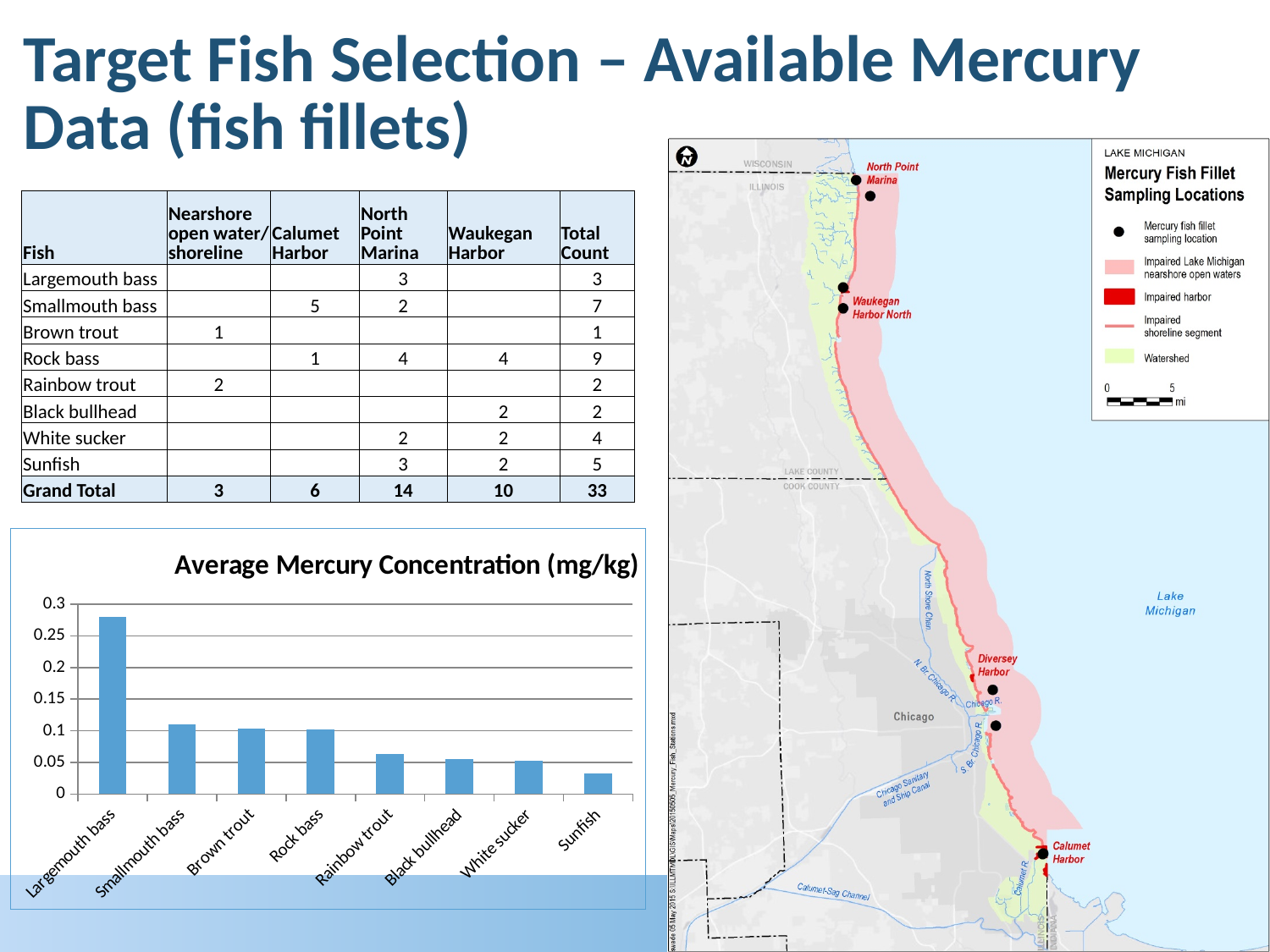
Which fish has the highest average mercury concentration in the bar chart? Largemouth bass In the bar chart, is the average mercury concentration for Largemouth bass greater or less than 0.25? greater In the bar chart, is the average mercury concentration for Rainbow trout greater or less than 0.05? greater In the bar chart, is the average mercury concentration for Largemouth bass greater or less than 0.3? less Which fish has the lowest average mercury concentration in the bar chart? Sunfish What is the title of the bar chart on the slide? Average Mercury Concentration (mg/kg) In the bar chart, which has a higher average mercury concentration, Rock bass or White sucker? Rock bass In the bar chart, do the average mercury concentrations rise or fall from left to right along the x axis? fall How many fish species are plotted in the "Average Mercury Concentration (mg/kg)" chart? 8 What kind of chart is the "Average Mercury Concentration (mg/kg)" chart? bar chart In the bar chart, which has a higher average mercury concentration, Largemouth bass or Smallmouth bass? Largemouth bass